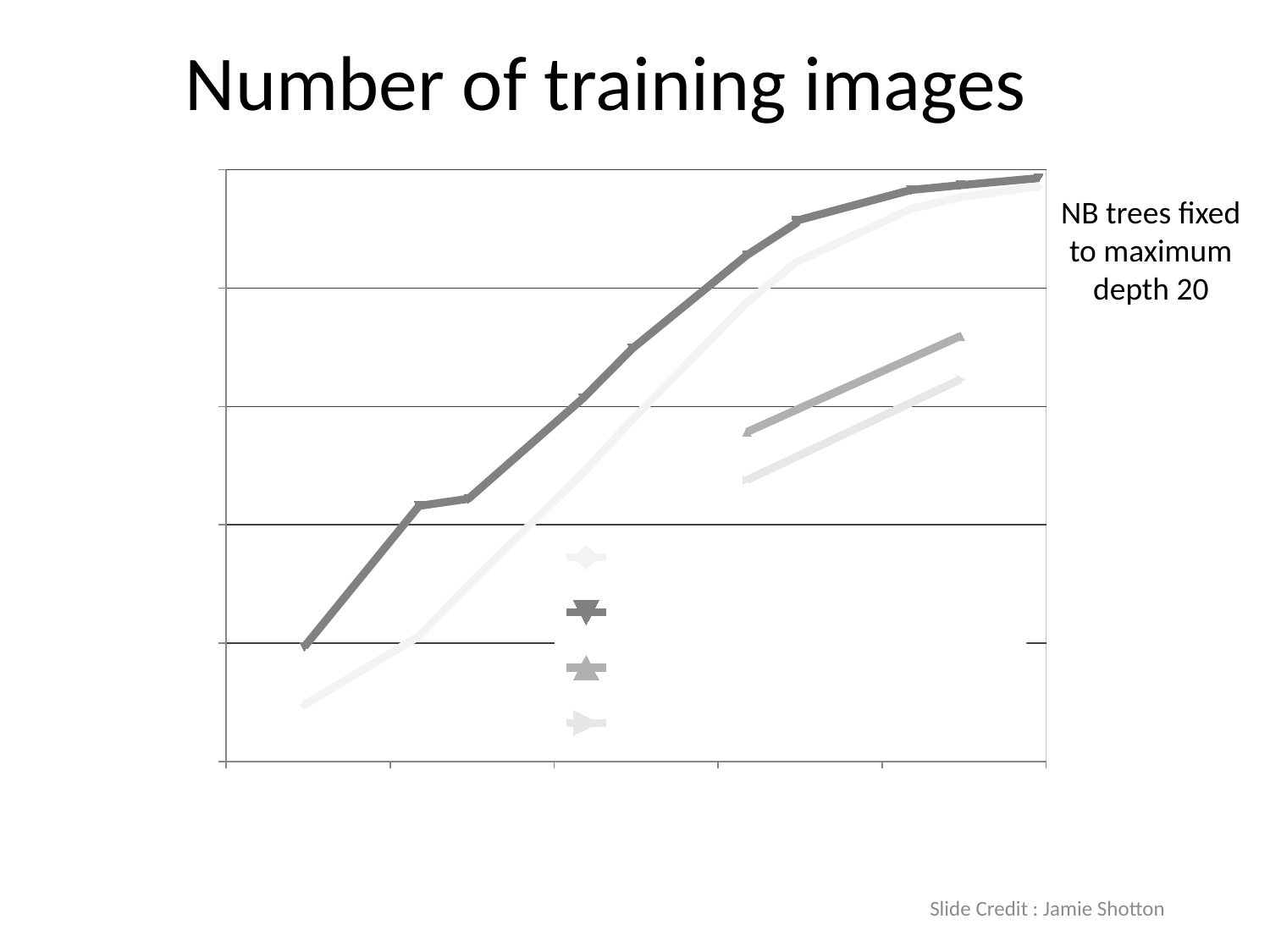
How many series does the legend list? 4 How many lines are plotted on the chart? 4 What is the title of the slide containing the chart? Number of training images Does the dark grey line rise or fall along the x axis? rise Do the plotted lines rise or fall as you move left to right along the x axis? rise What does the annotation to the right of the chart say? NB trees fixed to maximum depth 20 What kind of chart is shown on the slide? line chart